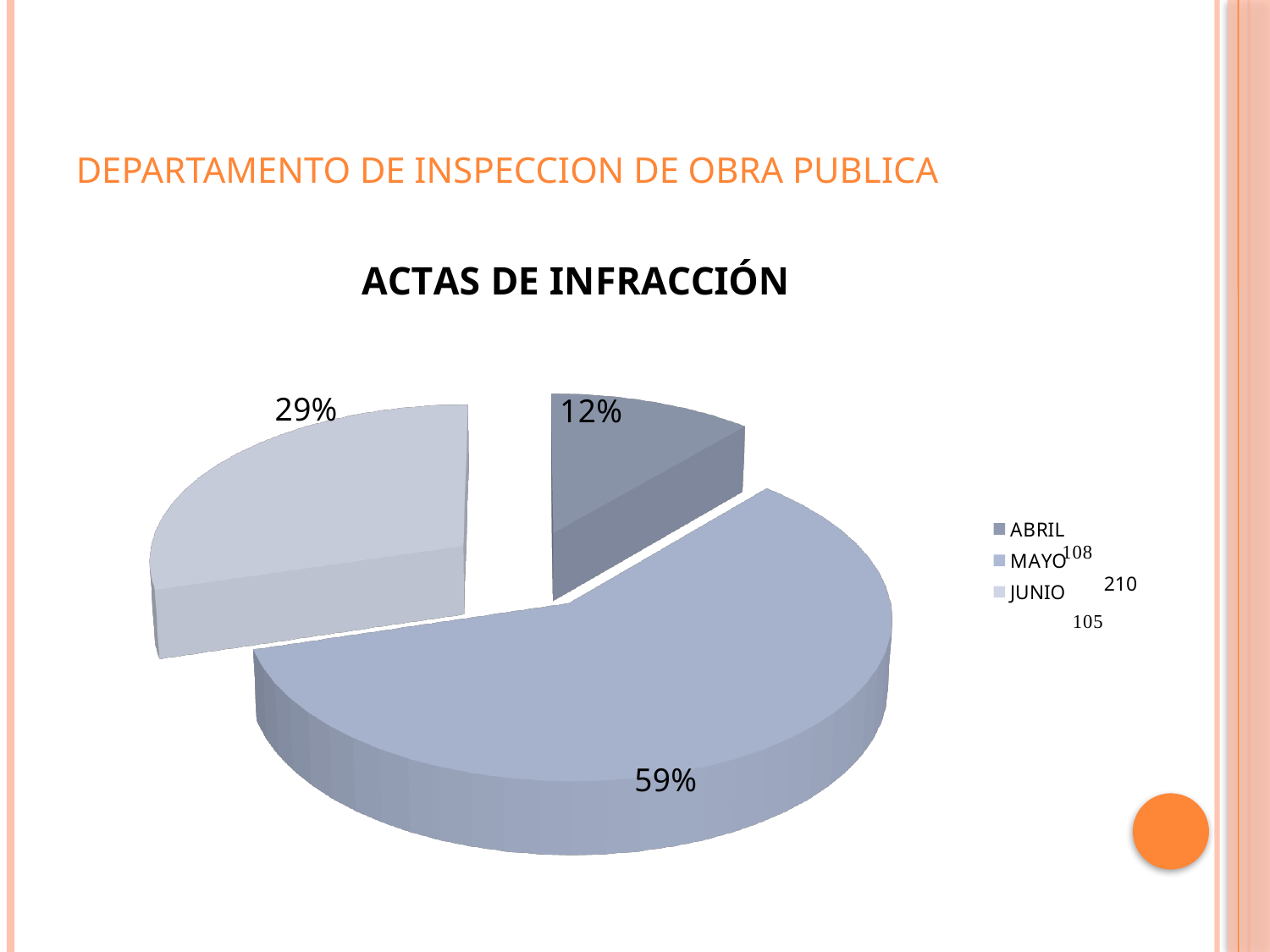
What share of the pie does MAYO represent? 59% How many slices does the pie chart have? 3 What is the difference in percentage points between the JUNIO and ABRIL slices? 17 What share of the pie does JUNIO represent? 29% Which month has the largest slice of the pie? MAYO What is the difference in percentage points between the MAYO and JUNIO slices? 30 What is the title of the chart? ACTAS DE INFRACCIÓN What kind of chart is shown on the slide? Pie chart Which month has the smallest slice of the pie? ABRIL How many entries does the legend list? 3 Which slice is larger, JUNIO or ABRIL? JUNIO What share of the pie does ABRIL represent? 12%